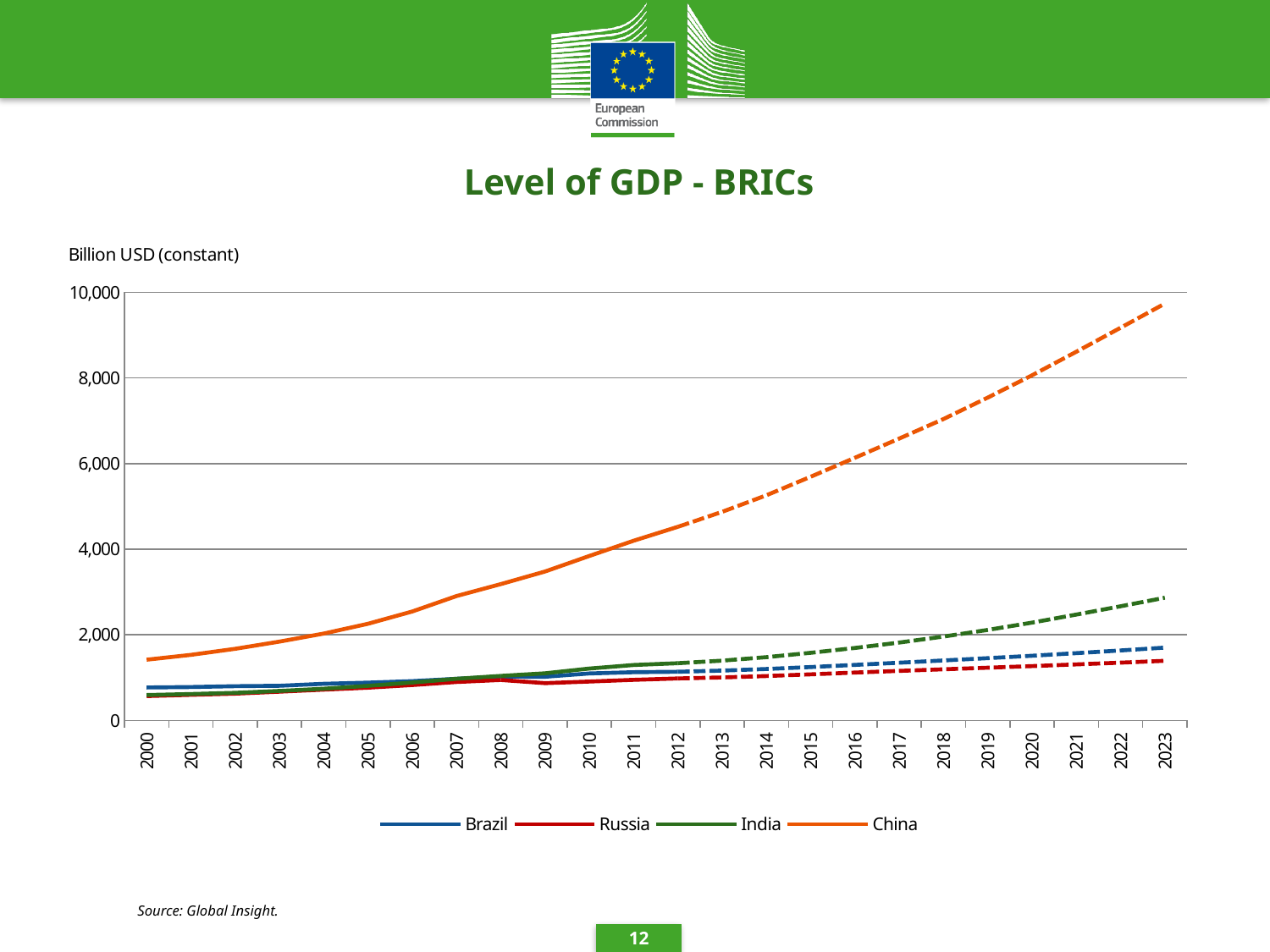
How many series does the legend list? 4 Is the value for China in 2012 greater or less than 4,000? greater What kind of chart is shown on the slide? line chart Which country has the lowest GDP level in 2023? Russia How many years are shown on the x axis? 24 Which country has the highest GDP level in 2023? China What unit is the y axis measured in, according to the label above the chart? Billion USD (constant) Is the value for India in 2023 greater or less than 2,000? greater Is the value for Brazil in 2023 greater or less than 2,000? less Which is larger in 2023, the value for China or the value for India? China Does the GDP level for China rise or fall from 2000 to 2023? rise